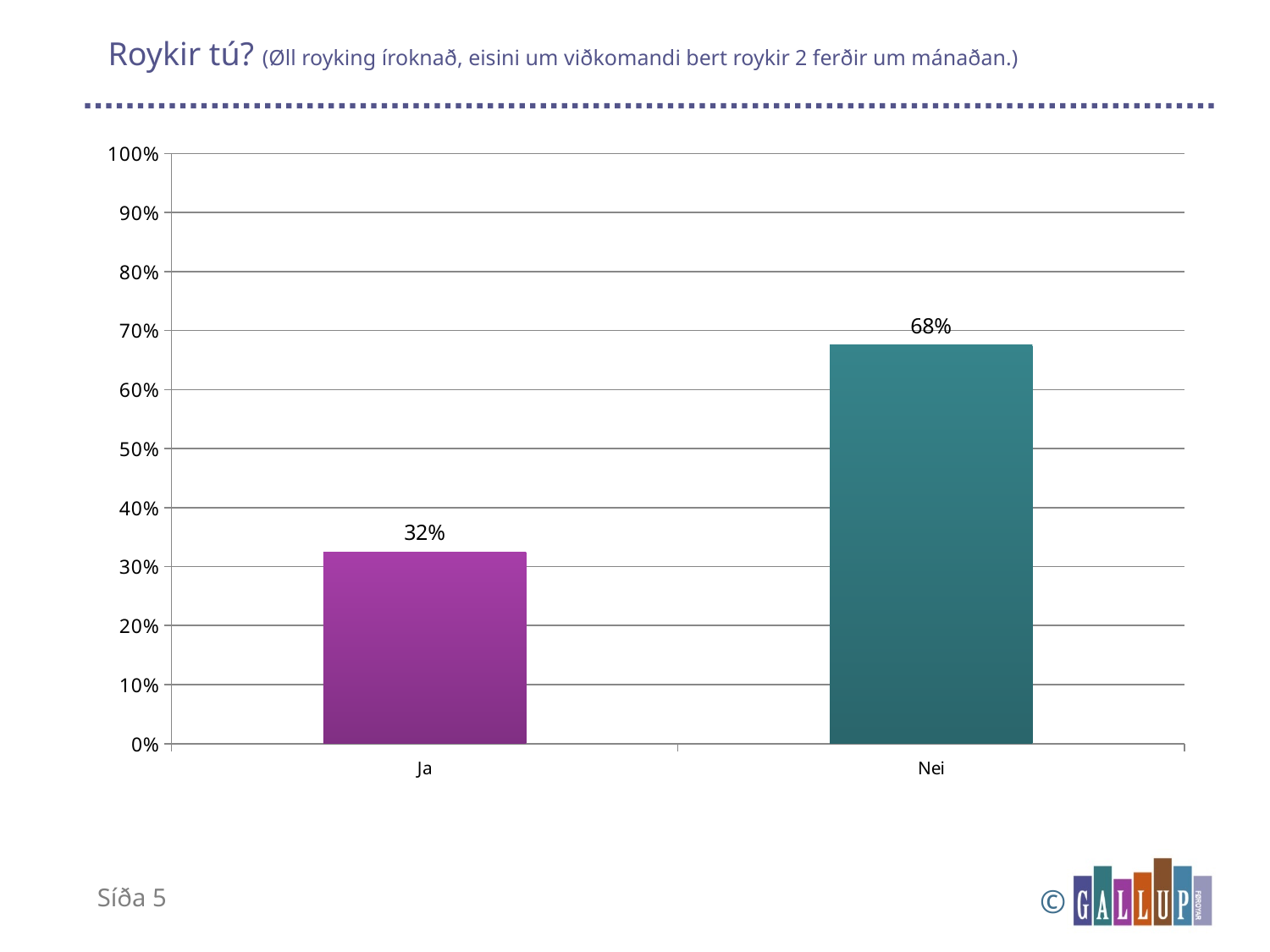
What is the value for Ja? 32% Is the value for Nei greater or less than 60%? greater Which category has the highest value? Nei Which category has the lowest value? Ja Is the value for Ja greater or less than 40%? less What is the difference between the values for Nei and Ja? 36% What is the value for Nei? 68% What is the total of the values for Ja and Nei? 100% What is the highest value shown on the y axis? 100% What kind of chart is shown on the slide? bar chart Which is larger, the value for Ja or the value for Nei? Nei How many categories are shown on the x axis? 2